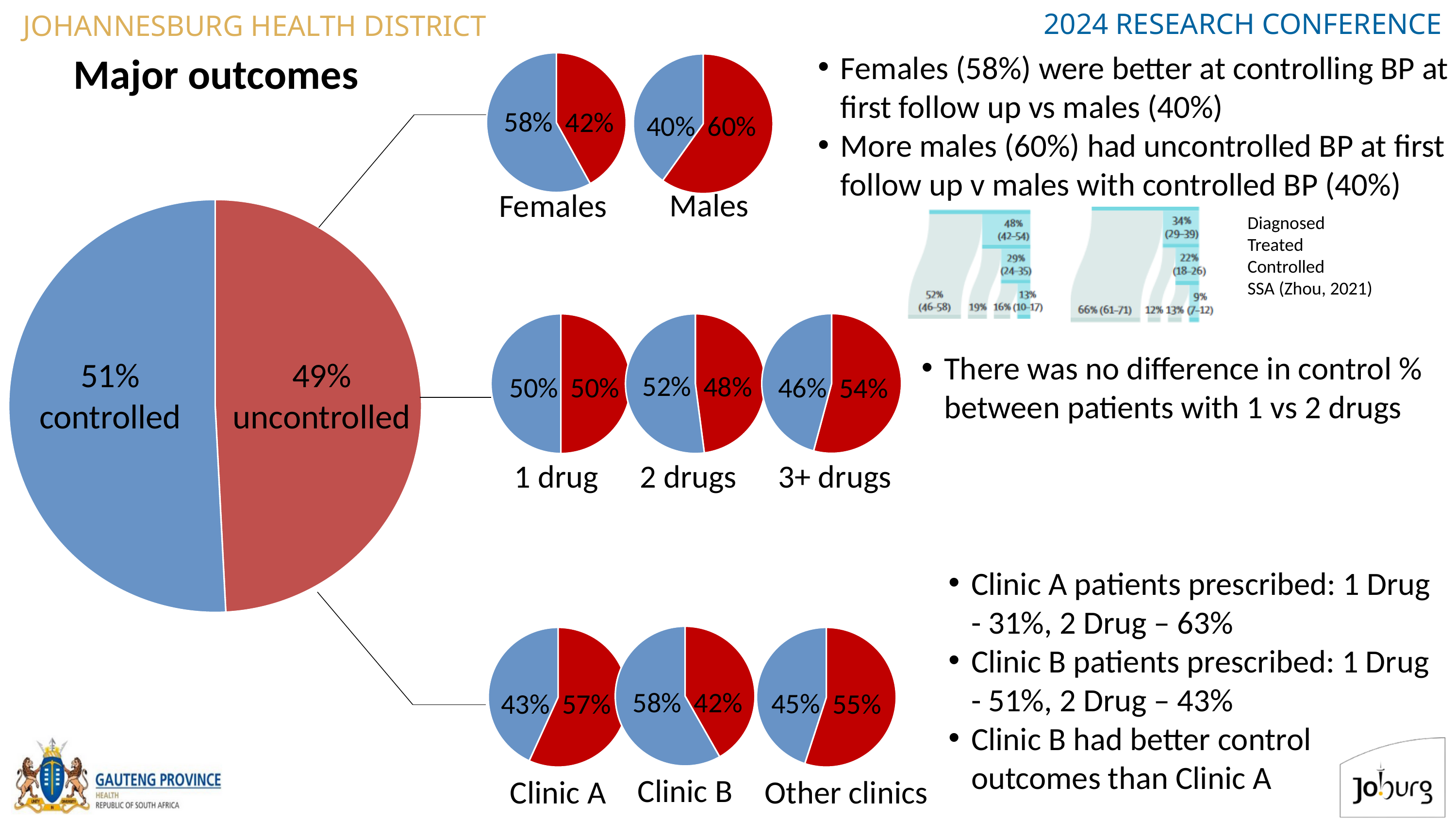
In the Clinic A pie chart, what is the red (uncontrolled) share? 57% In the large pie chart on the left, what percentage of patients had controlled blood pressure? 51% What kind of chart is used to show the major outcomes on this slide? Pie chart What is the difference between the controlled share in the Females pie chart (58%) and the controlled share in the Males pie chart (40%)? 18% In the Females pie chart, what is the blue (controlled) share? 58% Comparing the Females and Males pie charts, which group has the larger controlled (blue) share? Females In the large pie chart on the left, what percentage of patients were uncontrolled? 49% Among the Clinic A, Clinic B and Other clinics pie charts, which clinic has the highest blue (controlled) share? Clinic B In the 3+ drugs pie chart, what is the red (uncontrolled) share? 54% In the 2 drugs pie chart, what is the blue (controlled) share? 52% How many small pie charts are shown in the row for number of drugs (1 drug, 2 drugs, 3+ drugs)? 3 In the Males pie chart, what is the red (uncontrolled) share? 60%